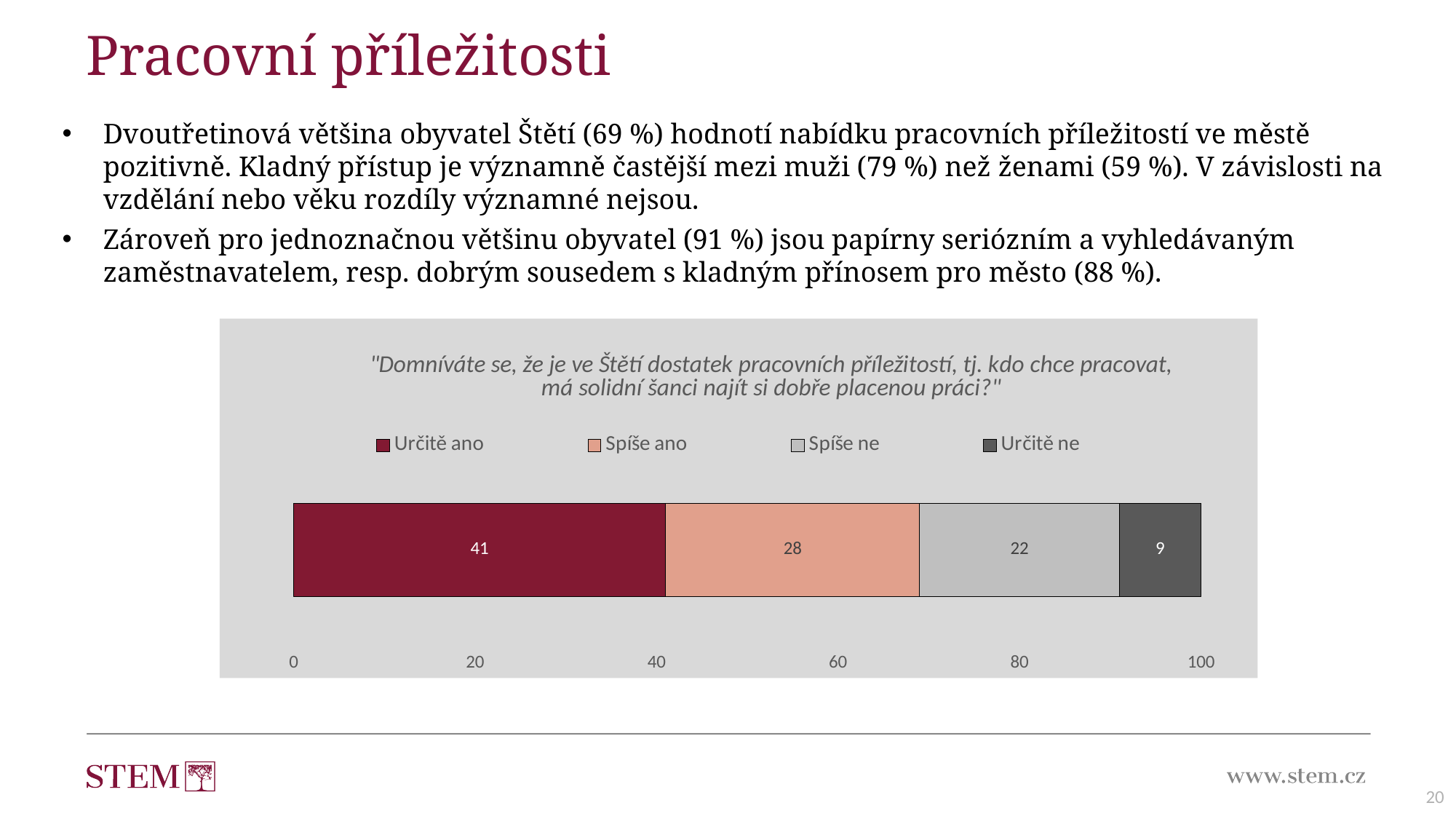
Which response category has the highest value in the chart? Určitě ano What kind of chart is shown on the slide? Stacked bar chart What is the total of the stacked bar in the chart? 100 What is the value for "Spíše ne" in the chart? 22 What is the value for "Spíše ano" in the chart? 28 What colour is the "Určitě ano" segment in the chart? Dark red How many series does the legend list? 4 Which is larger, the value for "Spíše ano" or the value for "Spíše ne"? Spíše ano What is the value for "Určitě ne" in the chart? 9 What is the difference between the values for "Určitě ano" and "Spíše ano"? 13 What is the value for "Určitě ano" in the chart? 41 Which response category has the lowest value in the chart? Určitě ne